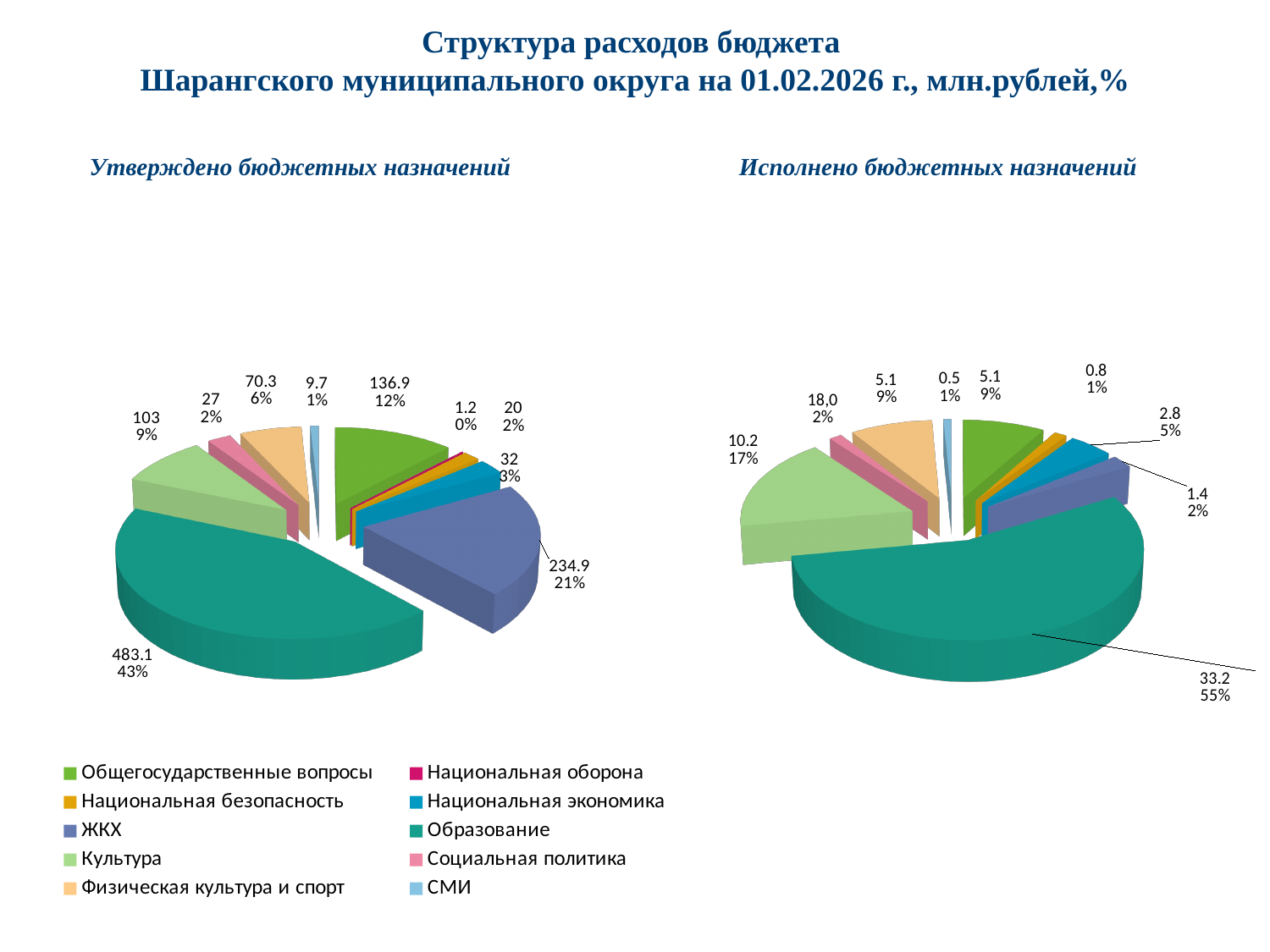
In the 'Исполнено бюджетных назначений' chart, what is the difference between Образование and Культура? 23 In the 'Утверждено бюджетных назначений' chart, which is larger: Культура or Физическая культура и спорт? Культура In the 'Утверждено бюджетных назначений' chart, what is the value for ЖКХ? 234.9 In the 'Утверждено бюджетных назначений' chart, which category has the largest slice? Образование In the 'Утверждено бюджетных назначений' chart, what is the difference between Образование and ЖКХ? 248.2 In the 'Утверждено бюджетных назначений' chart, what is the value for Образование? 483.1 In the 'Утверждено бюджетных назначений' chart, which category has the smallest value? Национальная оборона How many categories does the legend list? 10 What type of charts are shown on the slide? Pie charts In the 'Утверждено бюджетных назначений' chart, what share of the pie does Образование take? 43% In the 'Исполнено бюджетных назначений' chart, what is the value for Образование? 33.2 In the 'Исполнено бюджетных назначений' chart, what share of the pie does Культура take? 17%